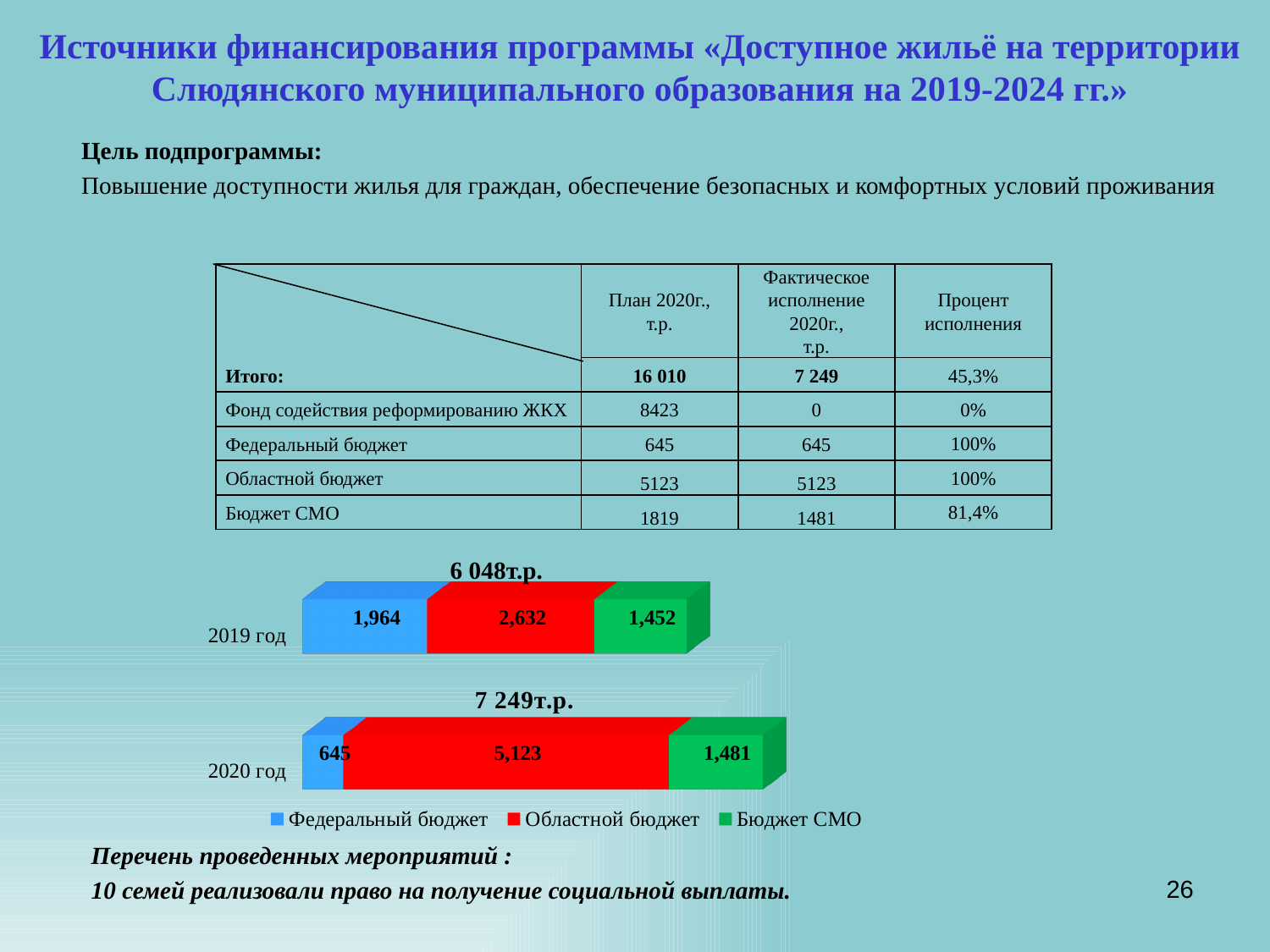
Which series has the smallest segment in the 2020 год bar? Федеральный бюджет What is the value of Областной бюджет for 2020 год in the chart? 5,123 How many series does the chart legend list? 3 What is the value of Федеральный бюджет for 2019 год in the chart? 1,964 What is the difference between Областной бюджет in 2020 год and in 2019 год? 2,491 Which is larger: Федеральный бюджет in 2019 год or Федеральный бюджет in 2020 год? 2019 год What is the total shown above the 2020 год bar? 7 249т.р. What is the value of Бюджет СМО for 2020 год in the chart? 1,481 Which series has the largest segment in the 2020 год bar? Областной бюджет How many categories (years) are plotted in the chart? 2 What type of chart is shown on the slide? stacked bar chart What is the total shown above the 2019 год bar? 6 048т.р.